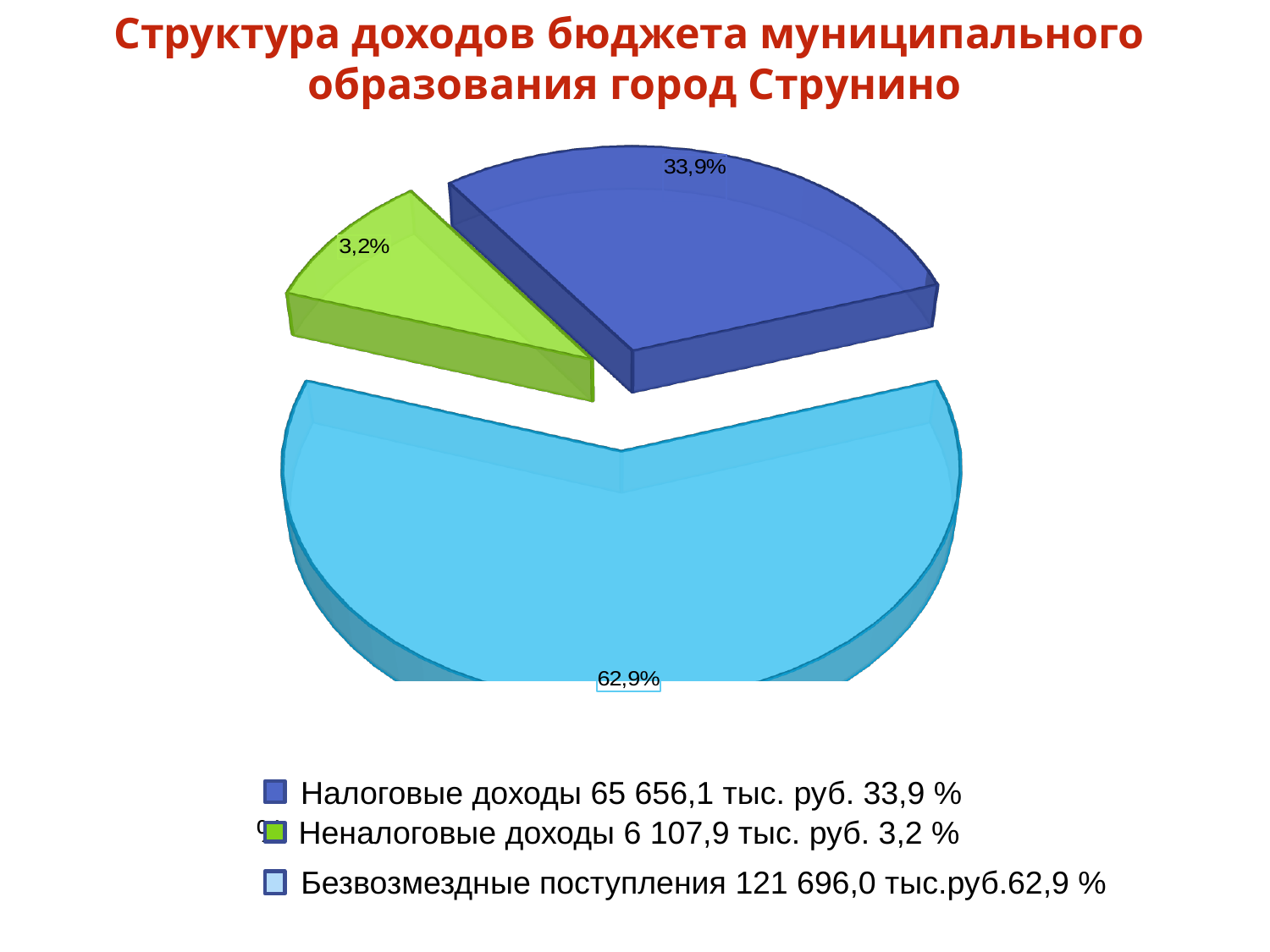
What amount in thousand rubles is listed in the legend for Налоговые доходы? 65 656,1 тыс. руб. What colour is the slice for Неналоговые доходы? green What kind of chart is shown on the slide? pie chart What share of the pie does Налоговые доходы represent? 33,9% Which category has the largest slice of the pie? Безвозмездные поступления What amount in thousand rubles is listed in the legend for Безвозмездные поступления? 121 696,0 тыс.руб. What share of the pie does Неналоговые доходы represent? 3,2% Which is larger: the share for Налоговые доходы or the share for Неналоговые доходы? Налоговые доходы What share of the pie does Безвозмездные поступления represent? 62,9% How many slices does the pie chart have? 3 What is the difference in percentage points between the Безвозмездные поступления share and the Налоговые доходы share? 29,0 Which category has the smallest slice of the pie? Неналоговые доходы